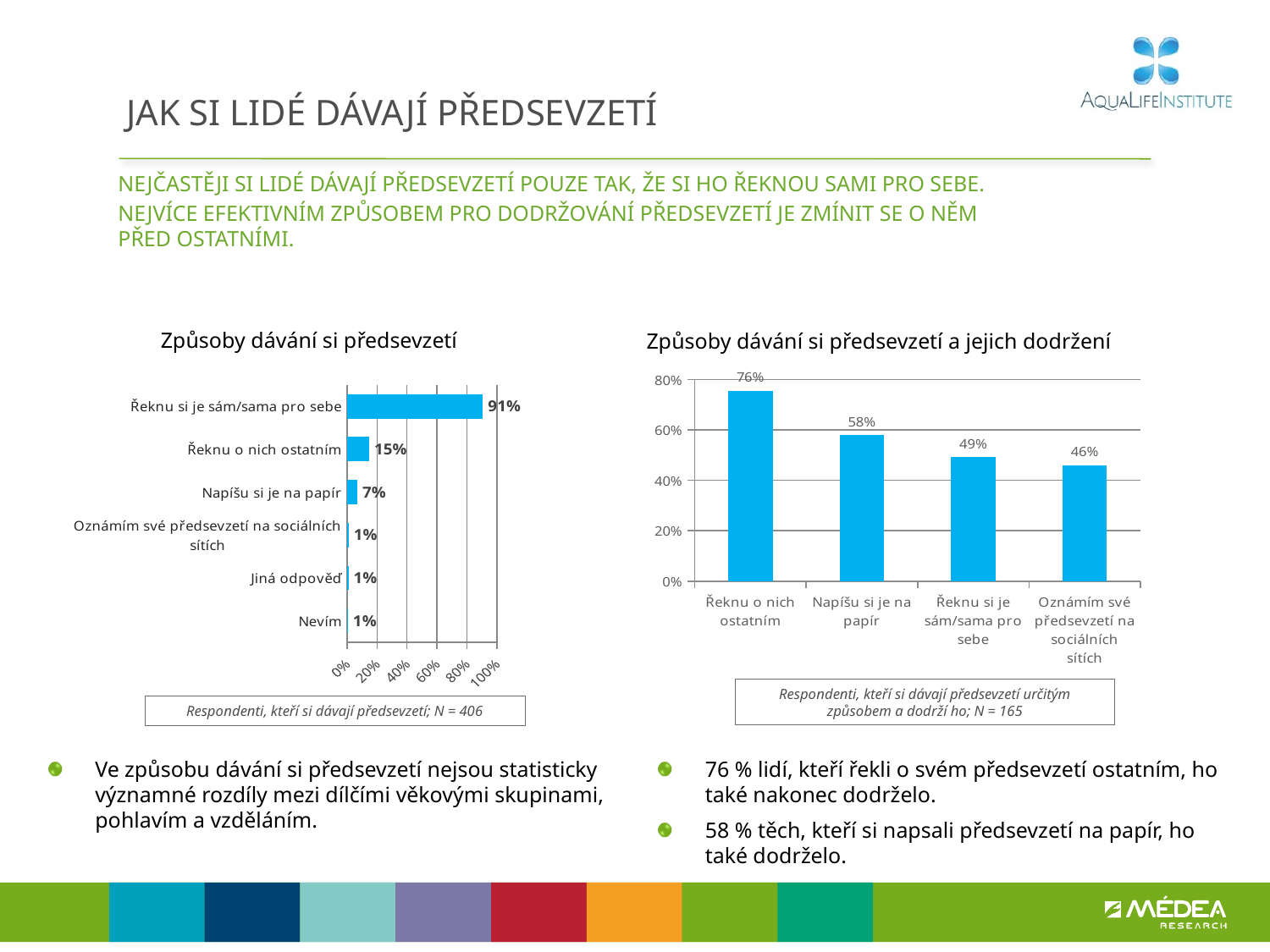
What kind of chart is 'Způsoby dávání si předsevzetí'? Bar chart In the chart 'Způsoby dávání si předsevzetí a jejich dodržení', do the values rise or fall from left to right? Fall In the chart 'Způsoby dávání si předsevzetí', how many categories are shown? 6 In the chart 'Způsoby dávání si předsevzetí a jejich dodržení', what is the value for 'Oznámím své předsevzetí na sociálních sítích'? 46% In the chart 'Způsoby dávání si předsevzetí', what is the value for 'Řeknu si je sám/sama pro sebe'? 91% In the chart 'Způsoby dávání si předsevzetí', what is the value for 'Napíšu si je na papír'? 7% In the chart 'Způsoby dávání si předsevzetí', what is the difference between 'Řeknu si je sám/sama pro sebe' and 'Řeknu o nich ostatním'? 76% In the chart 'Způsoby dávání si předsevzetí a jejich dodržení', what is the difference between 'Řeknu o nich ostatním' and 'Napíšu si je na papír'? 18% In the chart 'Způsoby dávání si předsevzetí', which category has the highest value? Řeknu si je sám/sama pro sebe In the chart 'Způsoby dávání si předsevzetí a jejich dodržení', which is larger: 'Napíšu si je na papír' or 'Řeknu si je sám/sama pro sebe'? Napíšu si je na papír In the chart 'Způsoby dávání si předsevzetí a jejich dodržení', which category has the lowest value? Oznámím své předsevzetí na sociálních sítích In the chart 'Způsoby dávání si předsevzetí a jejich dodržení', what is the value for 'Řeknu o nich ostatním'? 76%